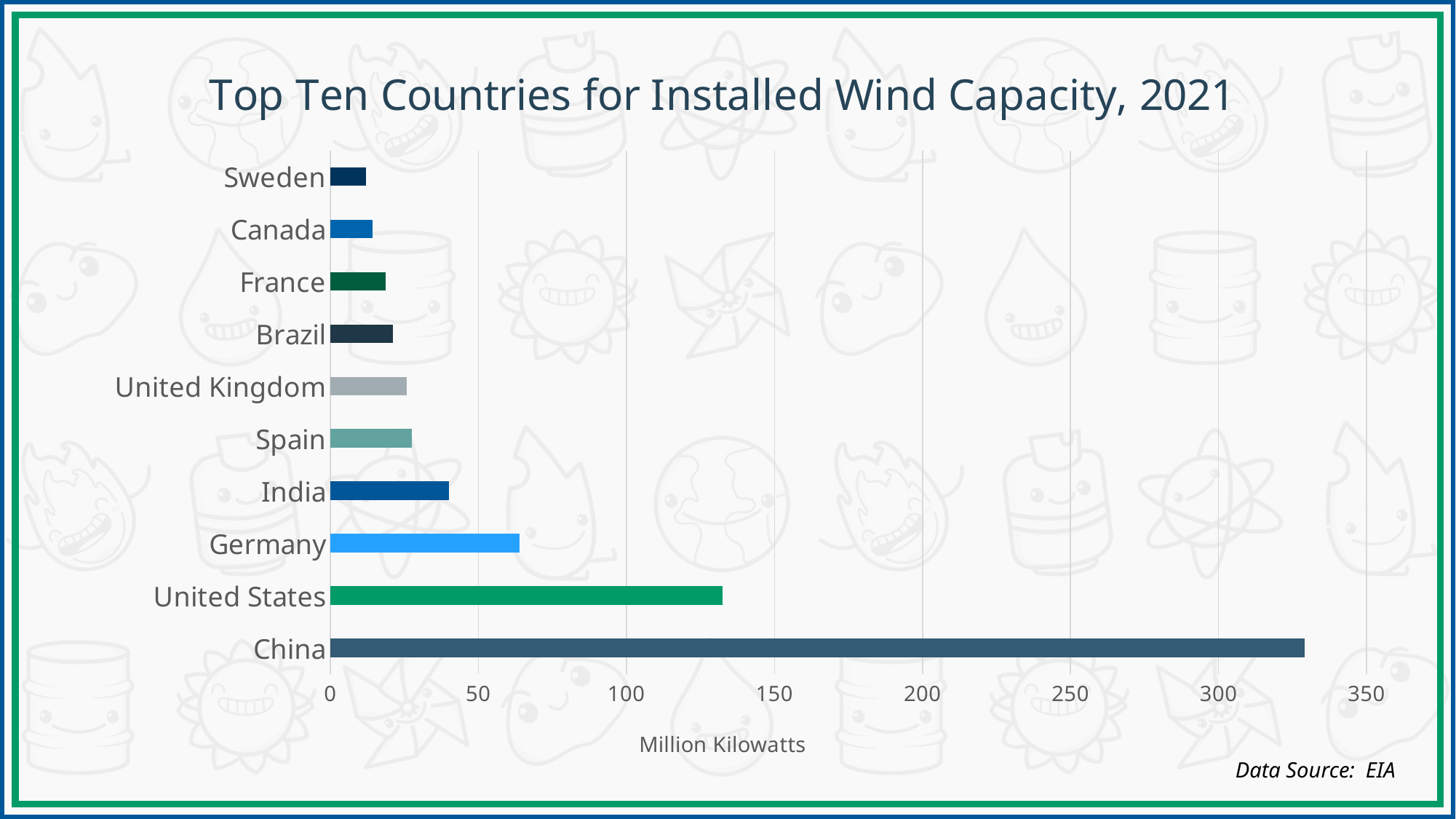
Which country has the highest installed wind capacity in the chart? China Is the value for the United States greater or less than 100? greater How many countries are shown in the chart? 10 Is the value for China greater or less than 300? greater Is the value for the United States greater or less than 150? less What kind of chart is shown on the slide? Bar chart What is the title of the chart? Top Ten Countries for Installed Wind Capacity, 2021 Which has the larger installed wind capacity, China or the United States? China What unit is shown on the horizontal axis of the chart? Million Kilowatts Which has the larger installed wind capacity, Germany or India? Germany